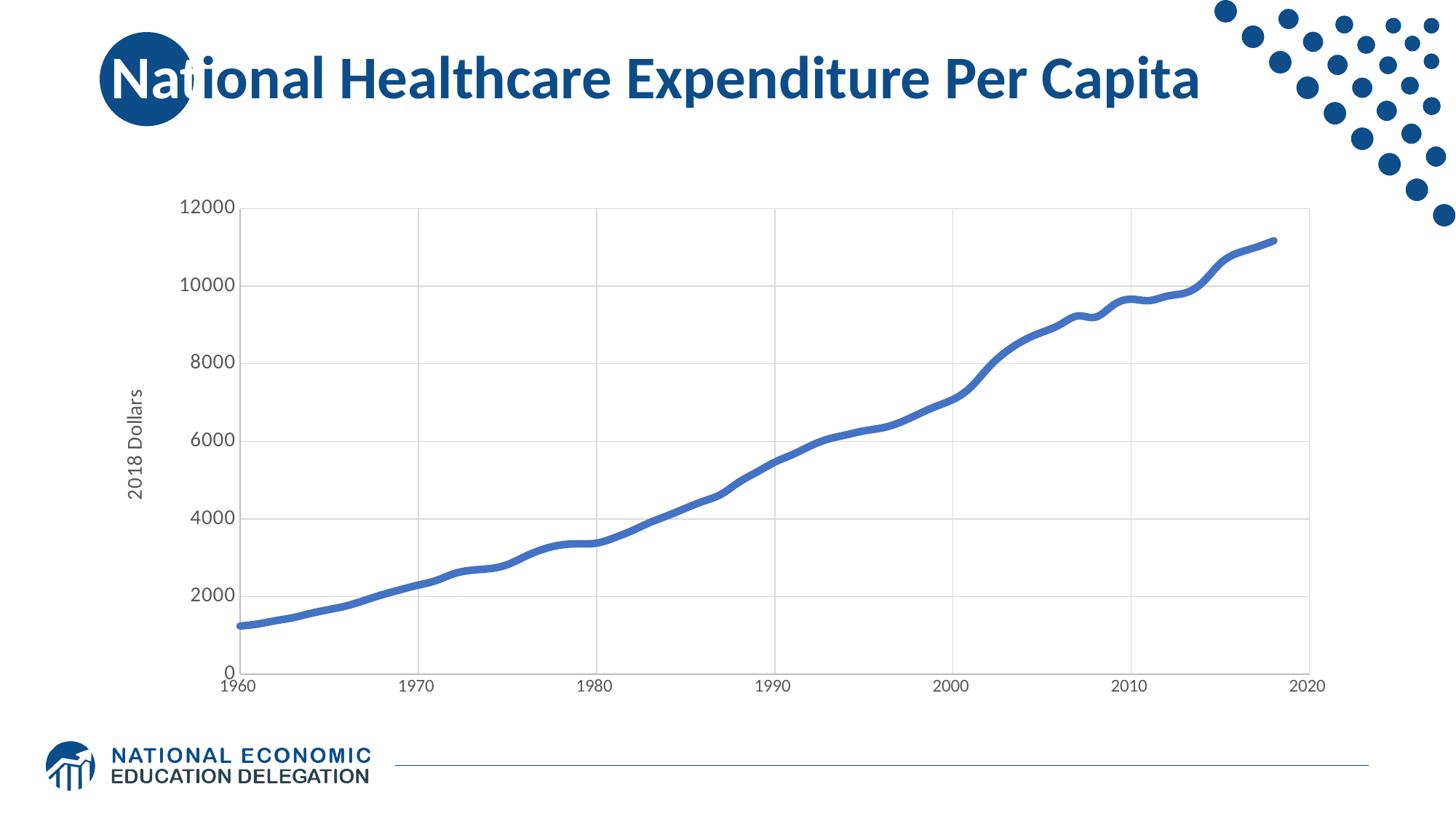
Is the value for 1990 greater or less than 4000? greater Do the values rise or fall from 1960 to 2018 along the x axis? rise Is the value for 1960 greater or less than 2000? less What kind of chart is shown on the slide? line chart Is the value at the end of the line (around 2018) greater or less than 10000? greater In which year shown on the x axis is the value lowest? 1960 Which of the two values is larger, the value for 1970 or the value for 2000? 2000 What is the label on the vertical axis of the chart? 2018 Dollars What is the title of the chart? National Healthcare Expenditure Per Capita